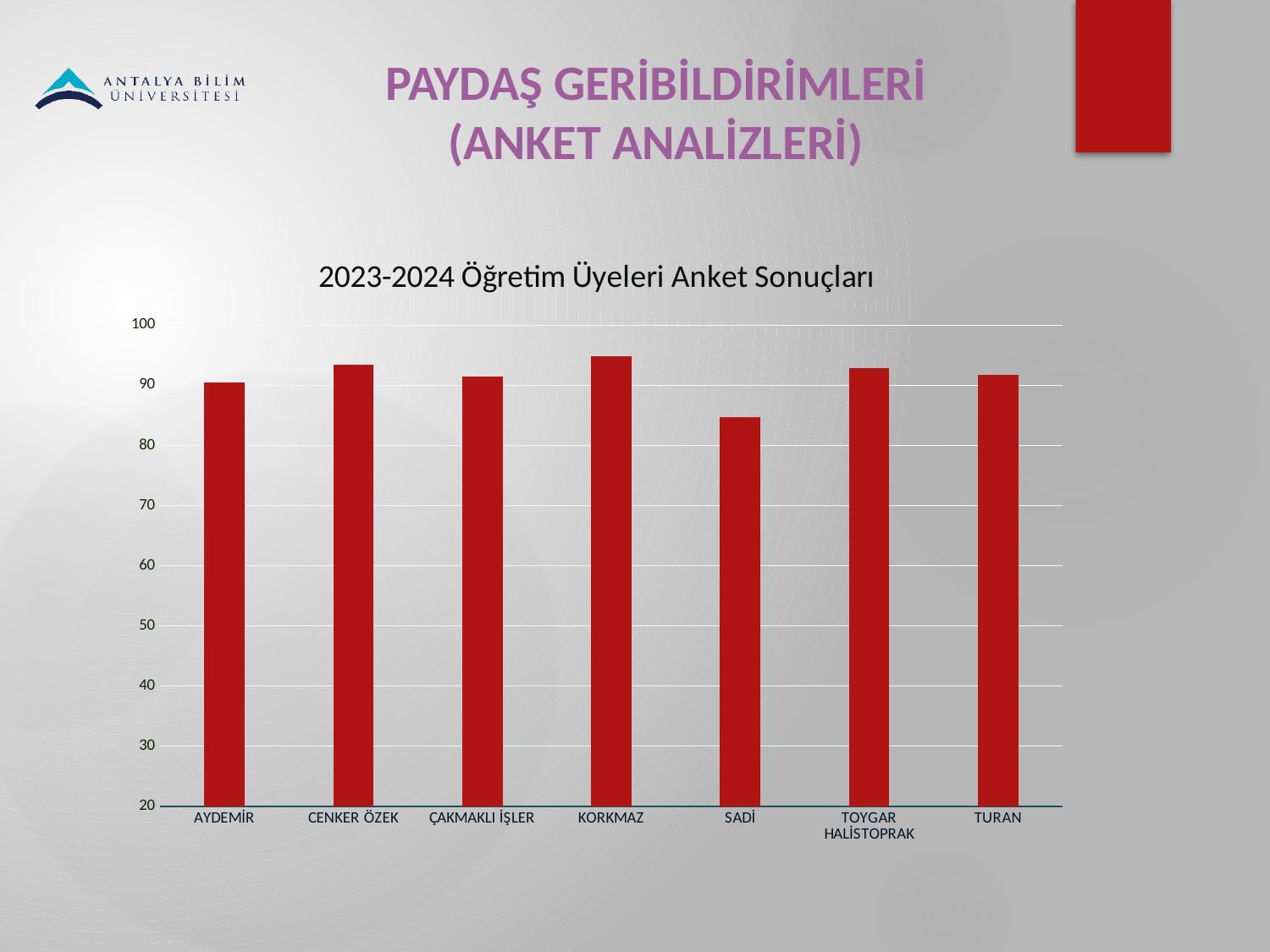
Is the value for KORKMAZ greater or less than 90? greater Which is larger, the value for SADİ or the value for KORKMAZ? KORKMAZ Is the value for SADİ greater or less than 90? less What type of chart is shown on the slide? bar chart What colour are the bars in the chart? red What is the title of the chart? 2023-2024 Öğretim Üyeleri Anket Sonuçları Which category has the lowest value in the chart? SADİ Is the value for CENKER ÖZEK greater or less than 90? greater How many categories are shown on the x axis of the chart? 7 Which is larger, the value for AYDEMİR or the value for SADİ? AYDEMİR Which category has the highest value in the chart? KORKMAZ